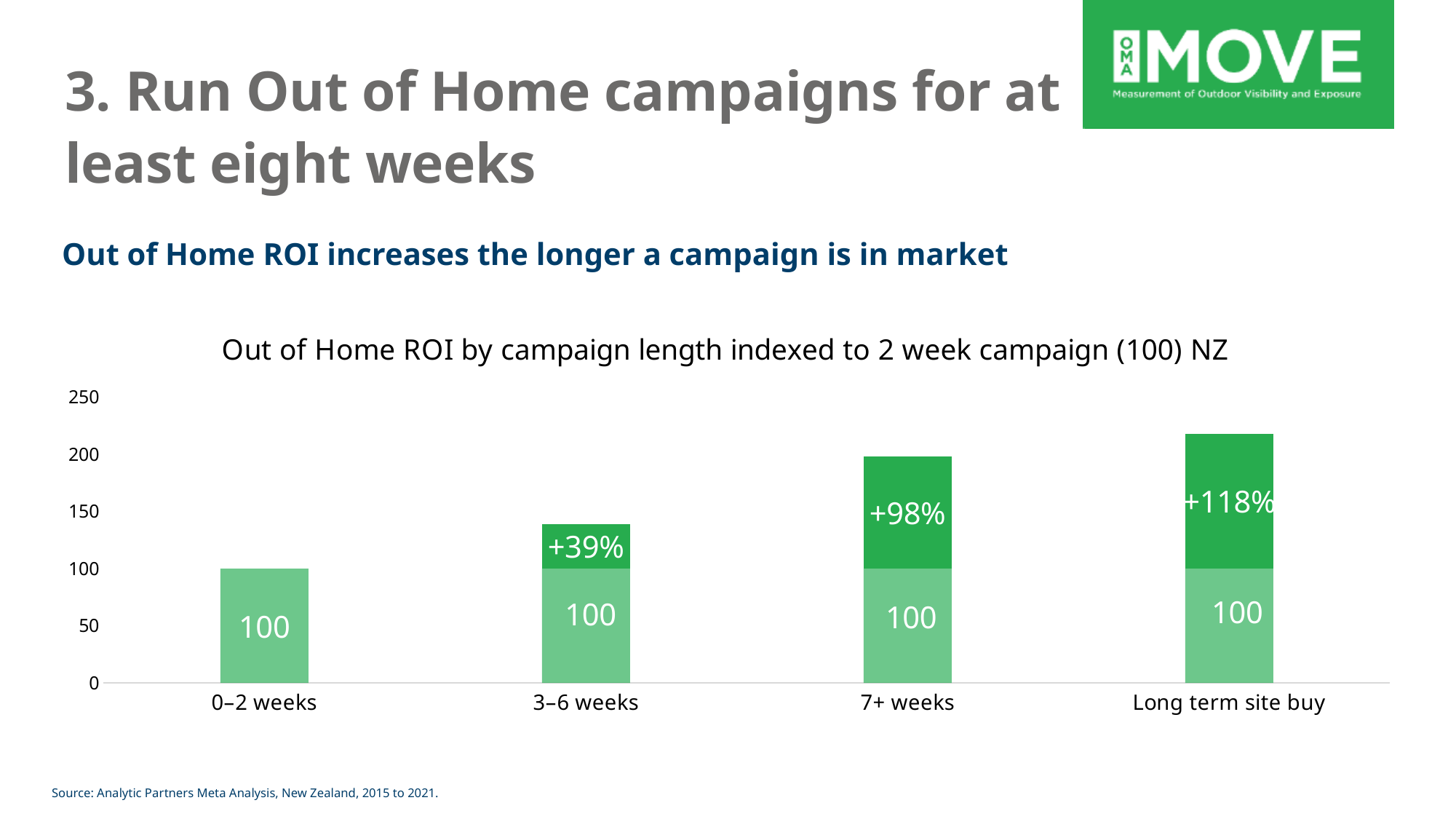
What is the title of the chart? Out of Home ROI by campaign length indexed to 2 week campaign (100) NZ Which campaign length has the highest indexed ROI? Long term site buy What uplift percentage is labelled on the 3–6 weeks bar? +39% Which has the taller bar, 3–6 weeks or 7+ weeks? 7+ weeks How many campaign length categories are shown on the x axis? 4 What is the indexed base value shown for the 0–2 weeks bar? 100 Do the bar heights rise or fall moving from left to right along the x axis? rise What uplift percentage is labelled on the 7+ weeks bar? +98% What kind of chart is shown on the slide? bar chart Is the total height of the 7+ weeks bar greater or less than 150? greater What uplift percentage is labelled on the Long term site buy bar? +118% Which campaign length has the lowest indexed ROI? 0–2 weeks